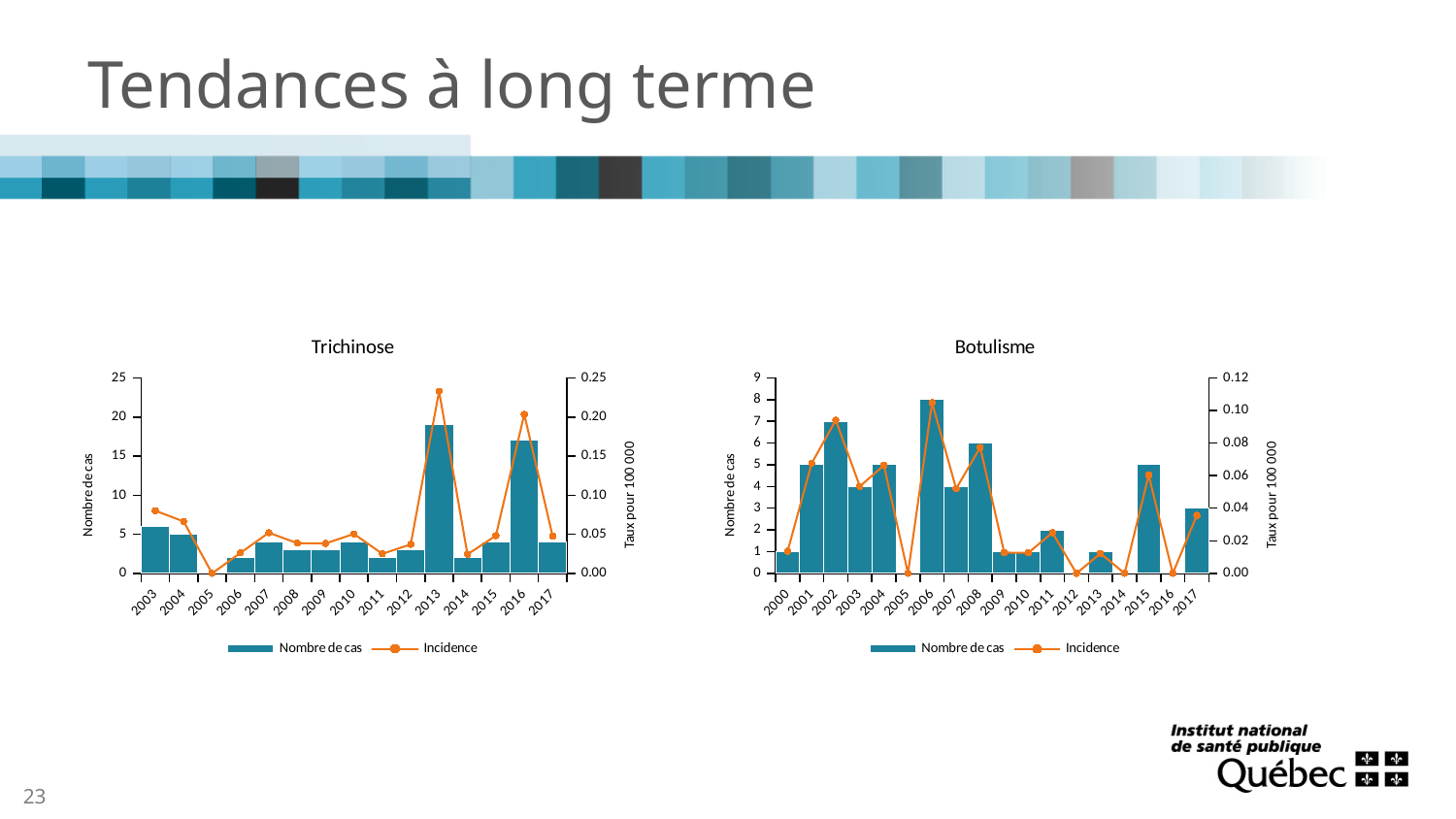
What is the label of the right-hand vertical axis in the Trichinose chart? Taux pour 100 000 In the Botulisme chart, which year has more cases, 2001 or 2011? 2001 How many series does the legend of the Trichinose chart list? 2 How many years are shown on the x axis of the Botulisme chart? 18 In the Botulisme chart, what is the difference in number of cases between 2006 and 2017? 5 In the Botulisme chart, what is the number of cases in 2002? 7 In the Trichinose chart, is the number of cases in 2016 greater or less than 15? greater In the Botulisme chart, which year has the highest number of cases? 2006 In the Trichinose chart, what is the number of cases in 2004? 5 In the Trichinose chart, which year has the highest number of cases? 2013 In the Trichinose chart, is the number of cases in 2013 greater or less than 15? greater In the Botulisme chart, what is the number of cases in 2006? 8